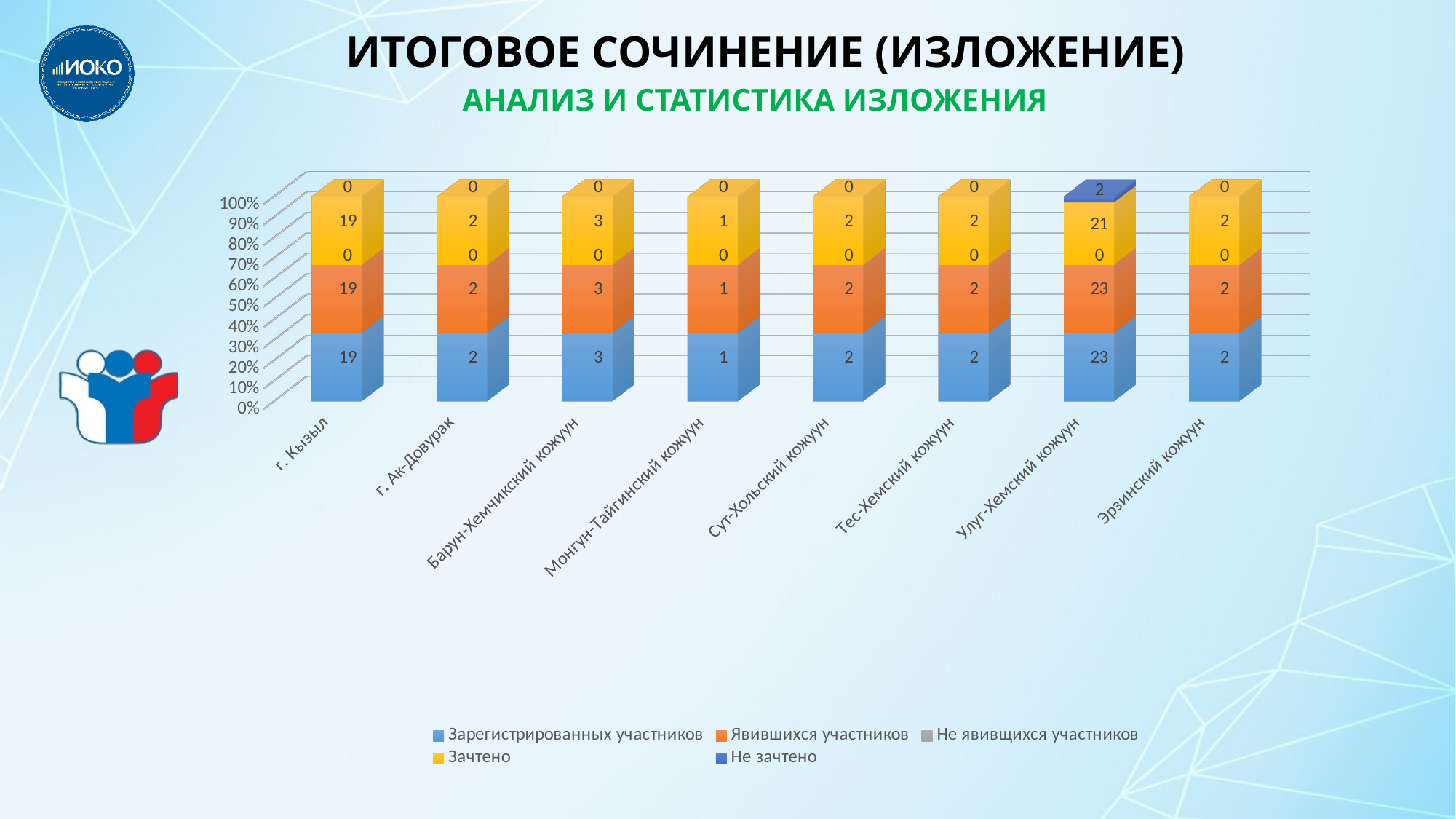
How many series does the chart legend list? 5 What is the value of Зачтено for Улуг-Хемский кожуун? 21 What kind of chart is shown on the slide? stacked bar chart Which series is shown in yellow in the chart legend? Зачтено How many categories (districts) are shown on the x axis of the chart? 8 What is the value of Зарегистрированных участников for г. Кызыл? 19 What is the value of Явившихся участников for Барун-Хемчикский кожуун? 3 Which category has the highest value of Зарегистрированных участников? Улуг-Хемский кожуун What is the difference between the Зарегистрированных участников values for Улуг-Хемский кожуун and г. Кызыл? 4 Which is larger: the Зачтено value for г. Кызыл or for Улуг-Хемский кожуун? Улуг-Хемский кожуун Which category has the lowest value of Зарегистрированных участников? Монгун-Тайгинский кожуун What is the value of Не зачтено for Улуг-Хемский кожуун? 2